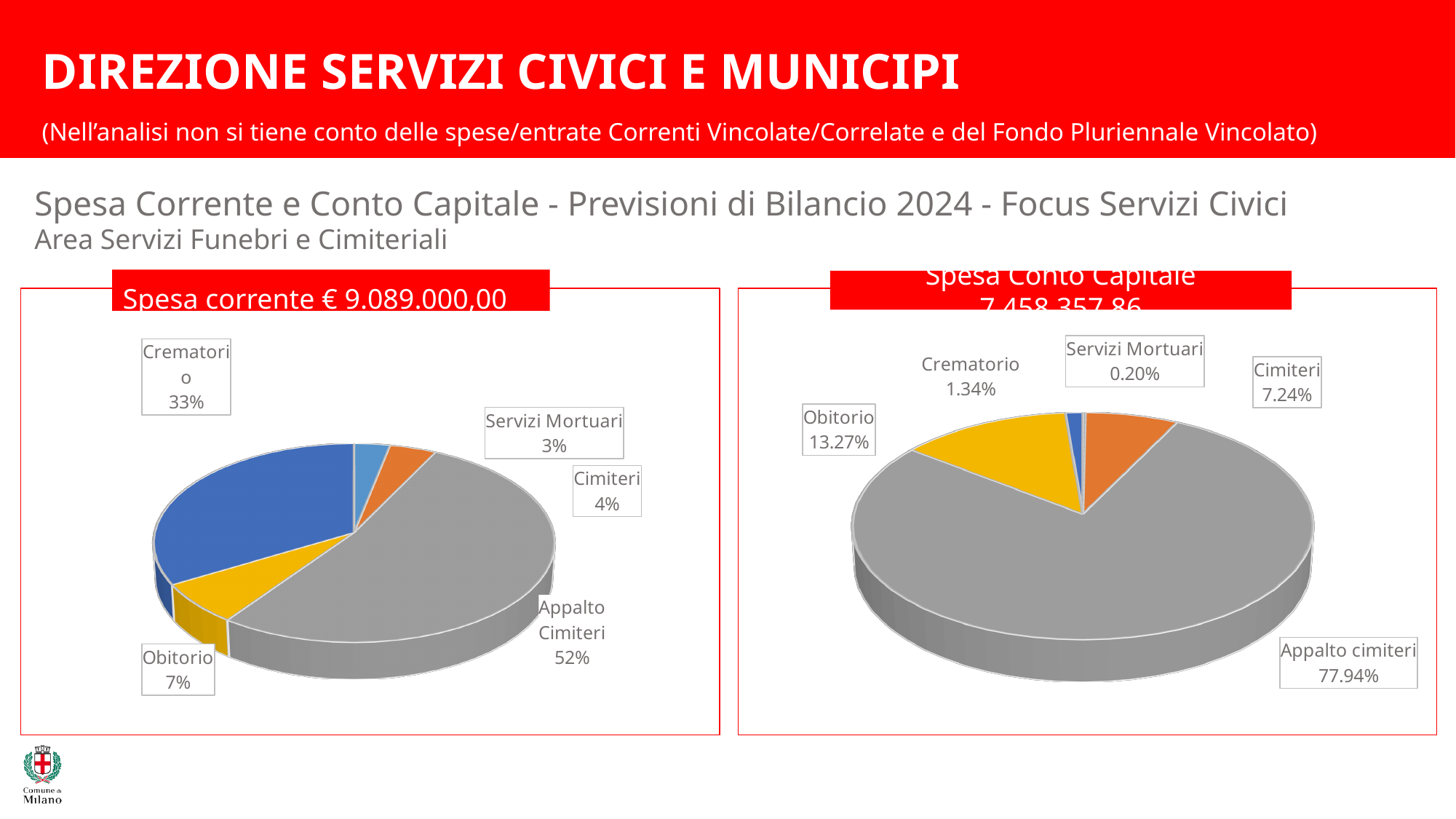
In the right pie chart (Spesa Conto Capitale), what share does Cimiteri have? 7.24% What total amount is shown in the title of the left chart (Spesa corrente)? € 9.089.000,00 In the left pie chart (Spesa corrente), what share does Obitorio have? 7% In the left pie chart (Spesa corrente), how many slices are there? 5 In the right pie chart (Spesa Conto Capitale), what share does Obitorio have? 13.27% In the right pie chart (Spesa Conto Capitale), which is larger: Crematorio or Cimiteri? Cimiteri In the left pie chart (Spesa corrente), which category has the largest share? Appalto Cimiteri In the left pie chart (Spesa corrente), which category has the smallest share? Servizi Mortuari What type of chart is used on the left side of the slide? Pie chart In the left pie chart (Spesa corrente), what is the difference in percentage points between Appalto Cimiteri and Crematorio? 19 In the left pie chart (Spesa corrente), what share does Crematorio have? 33% In the right pie chart (Spesa Conto Capitale), which category has the smallest share? Servizi Mortuari